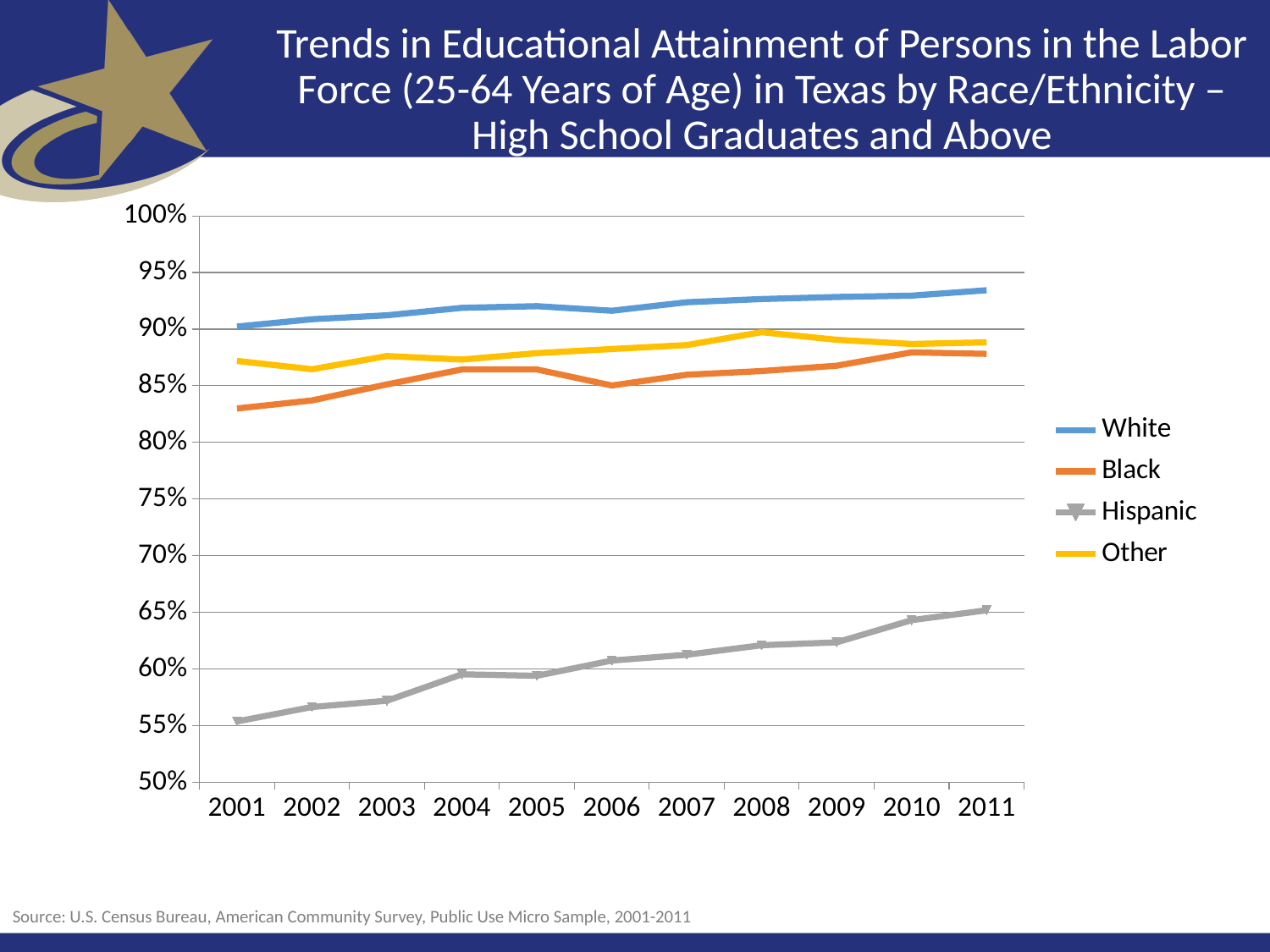
Is the value for Black in 2001 greater or less than 85%? less Which series has the highest values across all years? White Is the value for Hispanic in 2001 greater or less than 60%? less Which series has the lowest values across all years? Hispanic Is the value for White in 2011 greater or less than 90%? greater How many years are shown on the x axis? 11 Does the Hispanic series generally rise or fall from 2001 to 2011? rise Which series is drawn in gray with triangle markers? Hispanic How many series does the legend list? 4 In 2001, which is larger: the value for Black or the value for Other? Other What kind of chart is shown on the slide? line chart